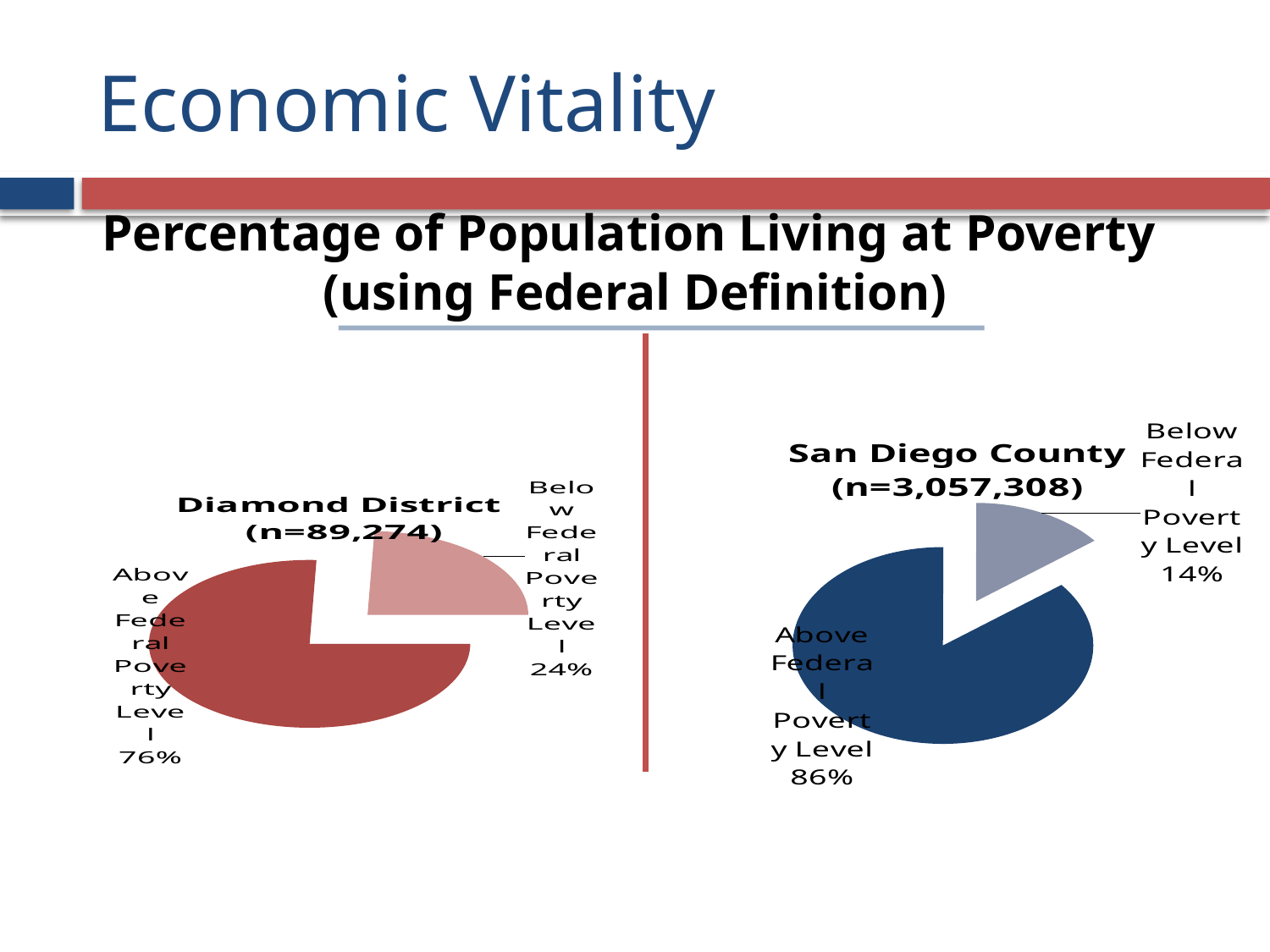
In the Diamond District chart, what is the difference between the above-poverty share and the below-poverty share? 52% What is the difference between the Diamond District's below-poverty share (24%) and San Diego County's below-poverty share (14%)? 10% What population size (n) is shown in the title of the San Diego County chart? n=3,057,308 In the San Diego County chart, what percentage of the population is above the federal poverty level? 86% Which is larger: the share below the federal poverty level in the Diamond District chart or in the San Diego County chart? Diamond District In the San Diego County chart, what percentage of the population is below the federal poverty level? 14% How many slices does the San Diego County pie chart have? 2 In the Diamond District chart, what percentage of the population is above the federal poverty level? 76% What kind of chart is the Diamond District chart? Pie chart In the San Diego County chart, which slice is the largest? Above Federal Poverty Level In the Diamond District chart, which slice is the smallest? Below Federal Poverty Level In the Diamond District chart, what percentage of the population is below the federal poverty level? 24%